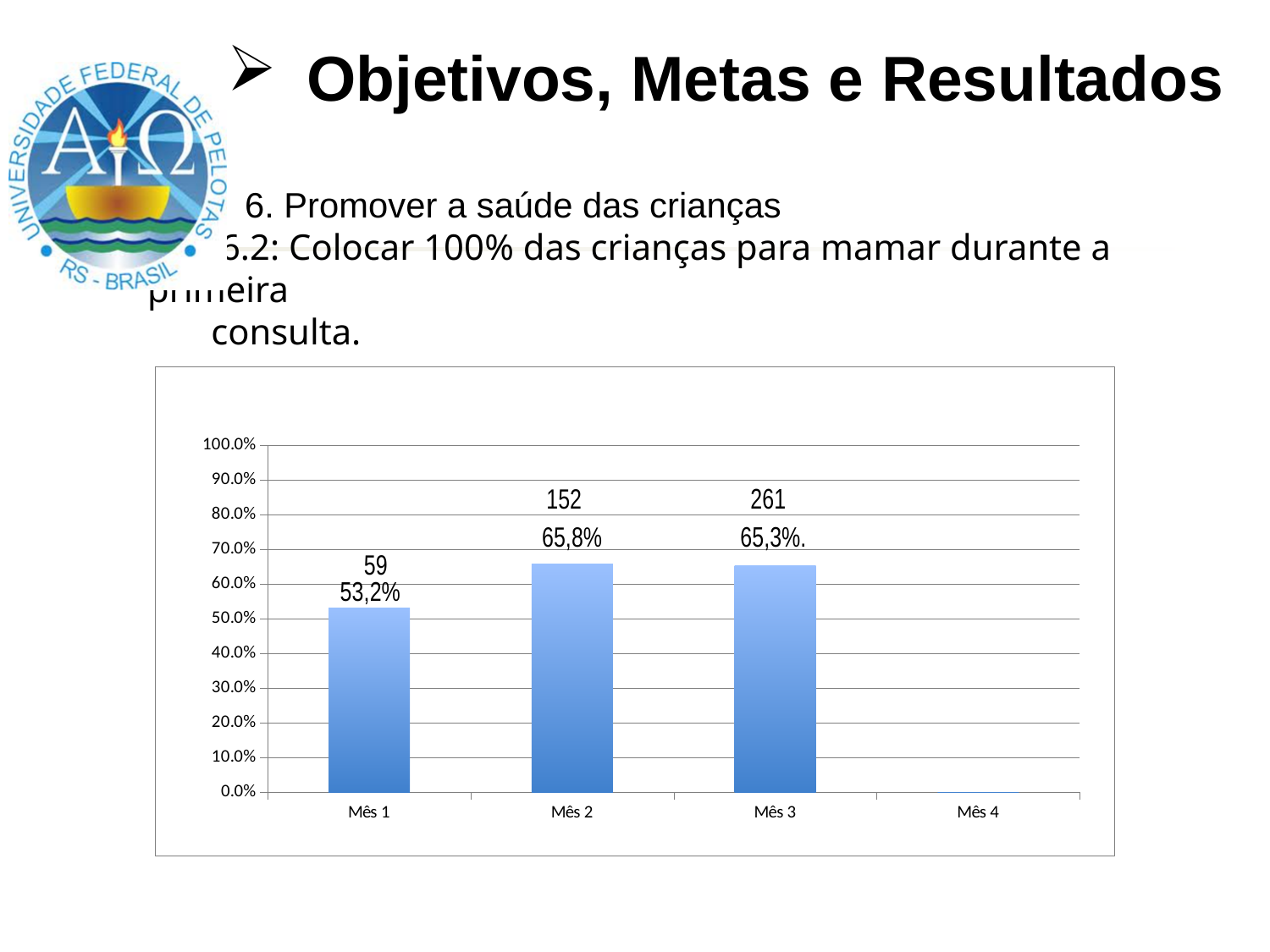
What number is printed above the bar for Mês 1? 59 Among Mês 1, Mês 2 and Mês 3, which month has the lowest percentage? Mês 1 What number is printed above the bar for Mês 3? 261 What percentage is shown for Mês 1? 53,2% What is the difference in percentage points between Mês 2 and Mês 1? 12,6% Is the value for Mês 1 greater or less than 60.0%? less What percentage is shown for Mês 3? 65,3% How many month categories are shown on the x axis? 4 What percentage is shown for Mês 2? 65,8% What kind of chart is shown on the slide? bar chart What is the difference between the numbers printed for Mês 2 and Mês 1? 93 Which is larger, the percentage for Mês 1 or for Mês 2? Mês 2